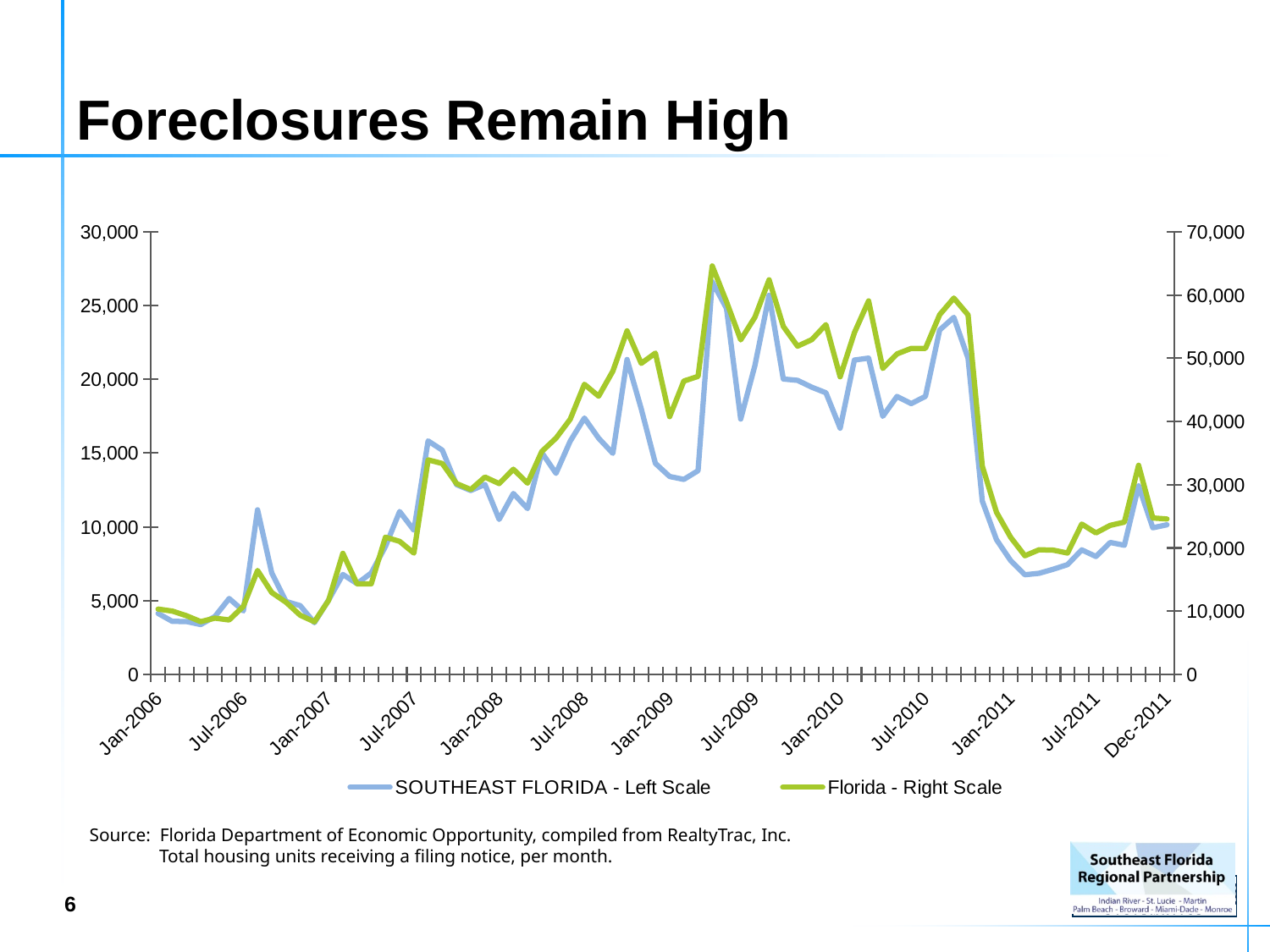
Which axis scale does the Florida series use, according to the legend? Right Scale In which year does the SOUTHEAST FLORIDA series reach its highest point? 2009 Is the Florida value at Dec-2011 greater or less than 20,000 on the right scale? greater What is the title of the slide's chart? Foreclosures Remain High Between Jan-2006 and Jul-2009, does the SOUTHEAST FLORIDA series generally rise or fall? rise Is the peak value of the SOUTHEAST FLORIDA series in 2009 greater or less than 25,000 on the left scale? greater What kind of chart is shown on the slide? line chart Is the Florida value at Jan-2010 greater or less than 40,000 on the right scale? greater How many series does the legend list? 2